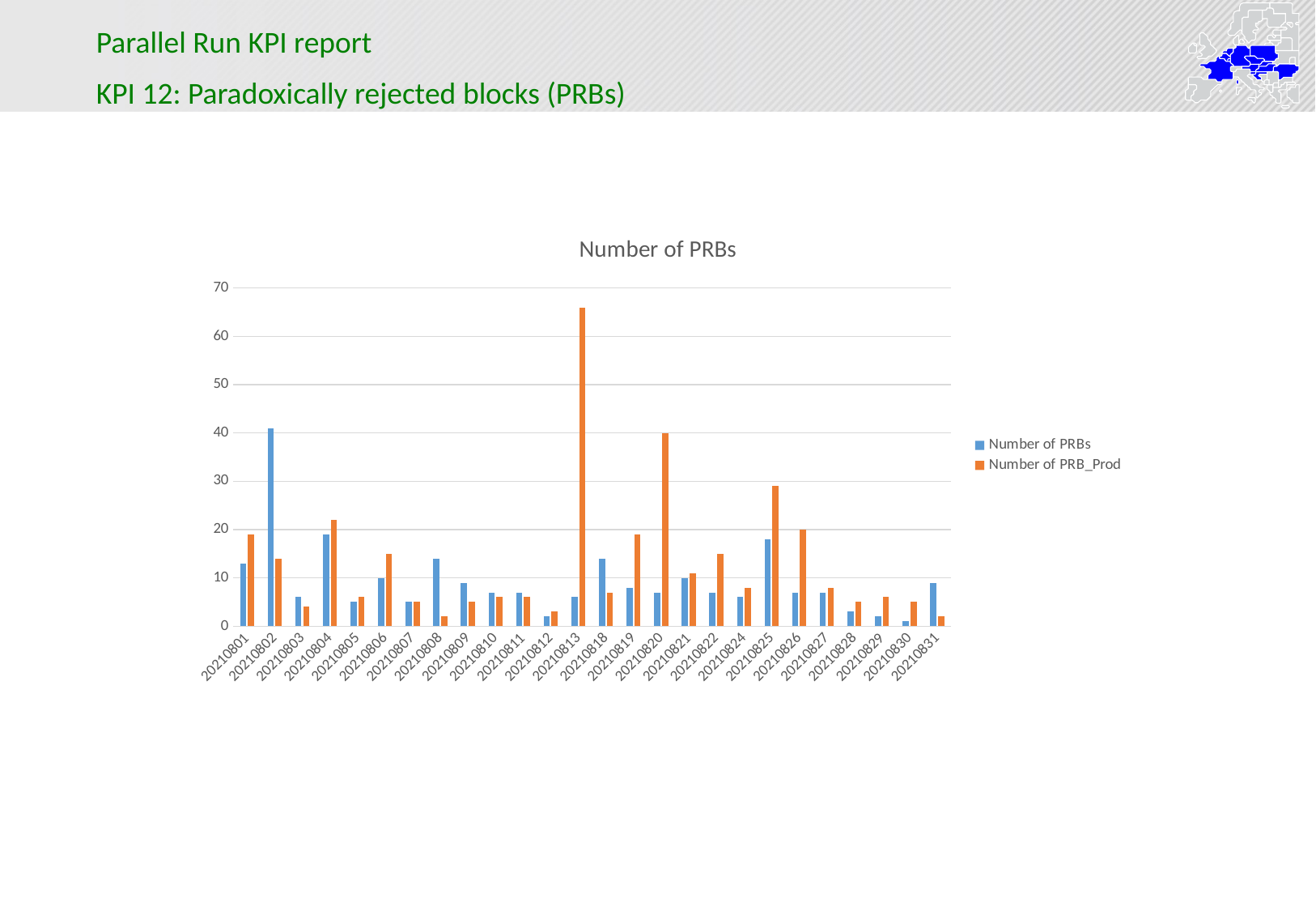
For 20210808, which series has the larger value, Number of PRBs or Number of PRB_Prod? Number of PRBs On which date is the Number of PRB_Prod value highest? 20210813 What is the title of the chart? Number of PRBs For 20210802, which series has the larger value, Number of PRBs or Number of PRB_Prod? Number of PRBs On which date is the Number of PRBs value highest? 20210802 How many series does the legend list? 2 Is the Number of PRBs value for 20210803 greater or less than 10? less Is the Number of PRB_Prod value for 20210820 greater or less than 30? greater On which date is the Number of PRBs value lowest? 20210830 How many dates are shown on the x axis of the chart? 26 What kind of chart is shown on the slide? bar chart Is the Number of PRB_Prod value for 20210813 greater or less than 60? greater